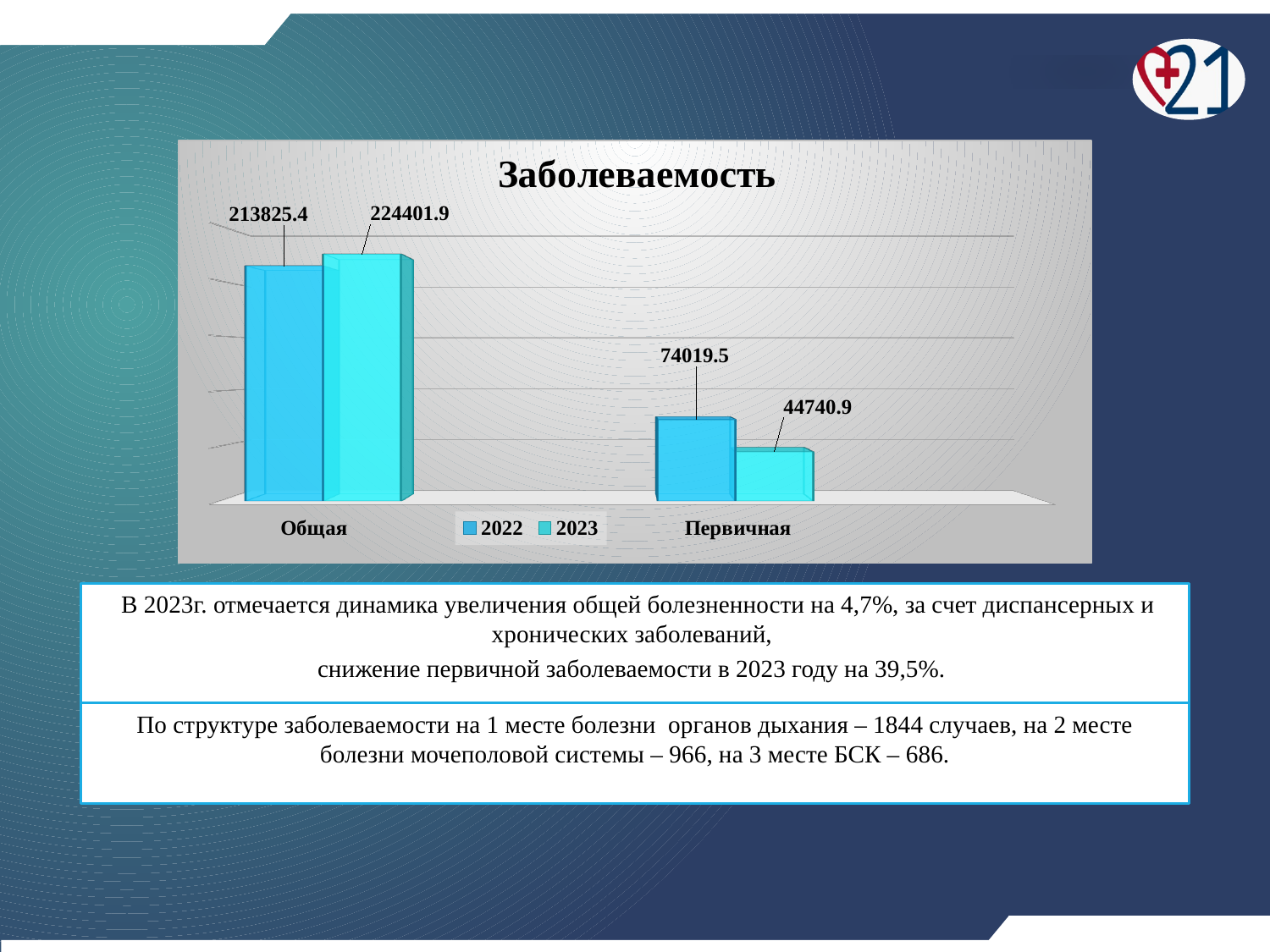
How many categories are shown on the x axis? 2 What is the title of the chart? Заболеваемость What is the difference between the 2023 and 2022 values for Общая? 10576.5 How many series does the legend list? 2 For Первичная, which series has the larger value, 2022 or 2023? 2022 Which bar has the lowest value on the chart? Первичная, 2023 What is the value for Общая in the 2022 series? 213825.4 What is the value for Первичная in the 2022 series? 74019.5 Which bar has the highest value on the chart? Общая, 2023 What is the value for Общая in the 2023 series? 224401.9 What is the value for Первичная in the 2023 series? 44740.9 What is the difference between the 2022 and 2023 values for Первичная? 29278.6